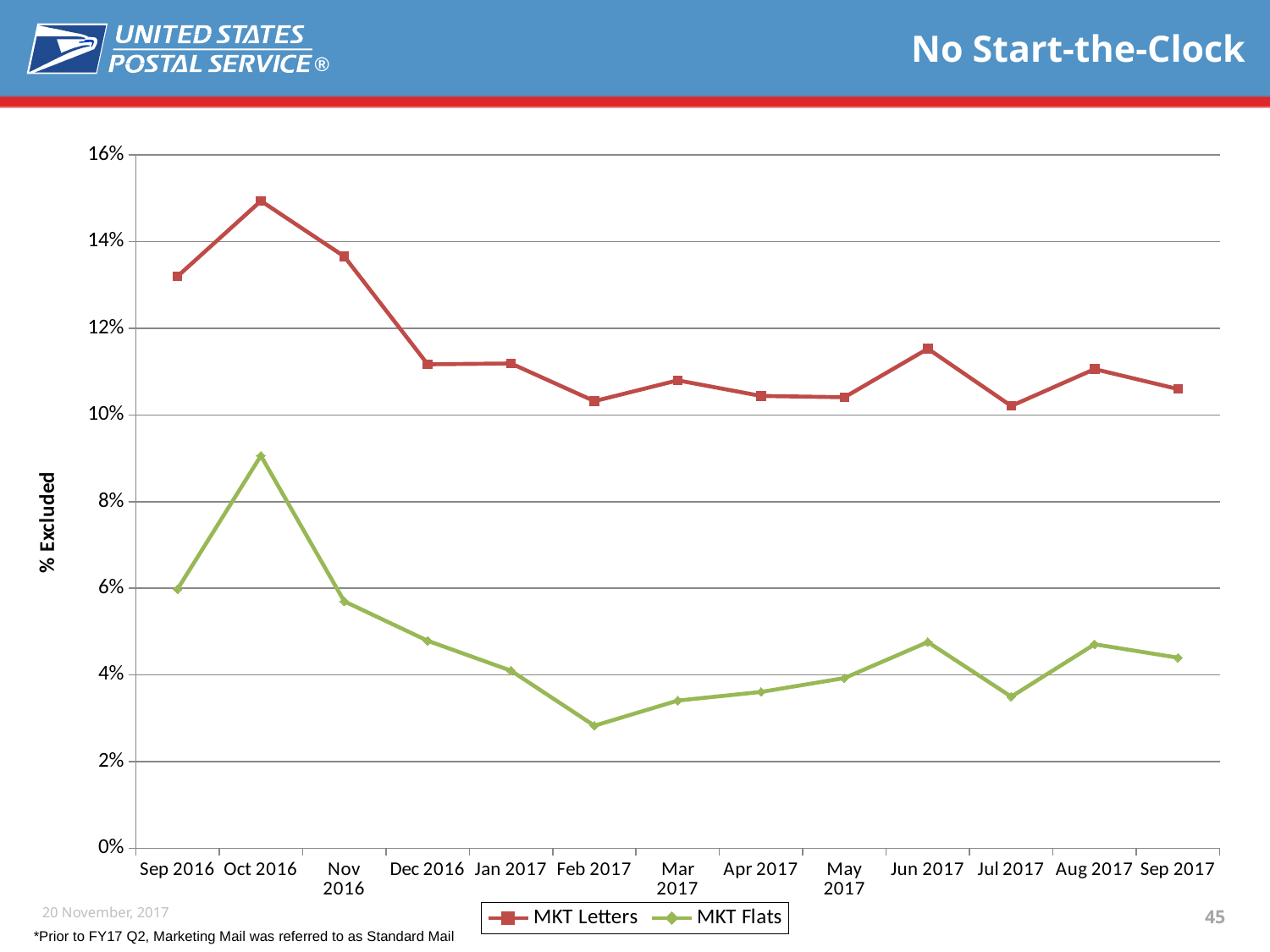
In which month does MKT Flats reach its highest value? Oct 2016 Which series has the larger value in Sep 2017, MKT Letters or MKT Flats? MKT Letters How many months are plotted along the x axis? 13 What kind of chart is shown on the slide? line chart What is the label on the vertical axis? % Excluded In which month does MKT Flats reach its lowest value? Feb 2017 Is the value for MKT Letters in Oct 2016 greater or less than 14%? greater Does the MKT Flats line rise or fall from Oct 2016 to Feb 2017? fall In which month does MKT Letters reach its highest value? Oct 2016 How many series does the legend list? 2 Is the value for MKT Flats in Feb 2017 greater or less than 4%? less Is the value for MKT Flats in Oct 2016 greater or less than 8%? greater